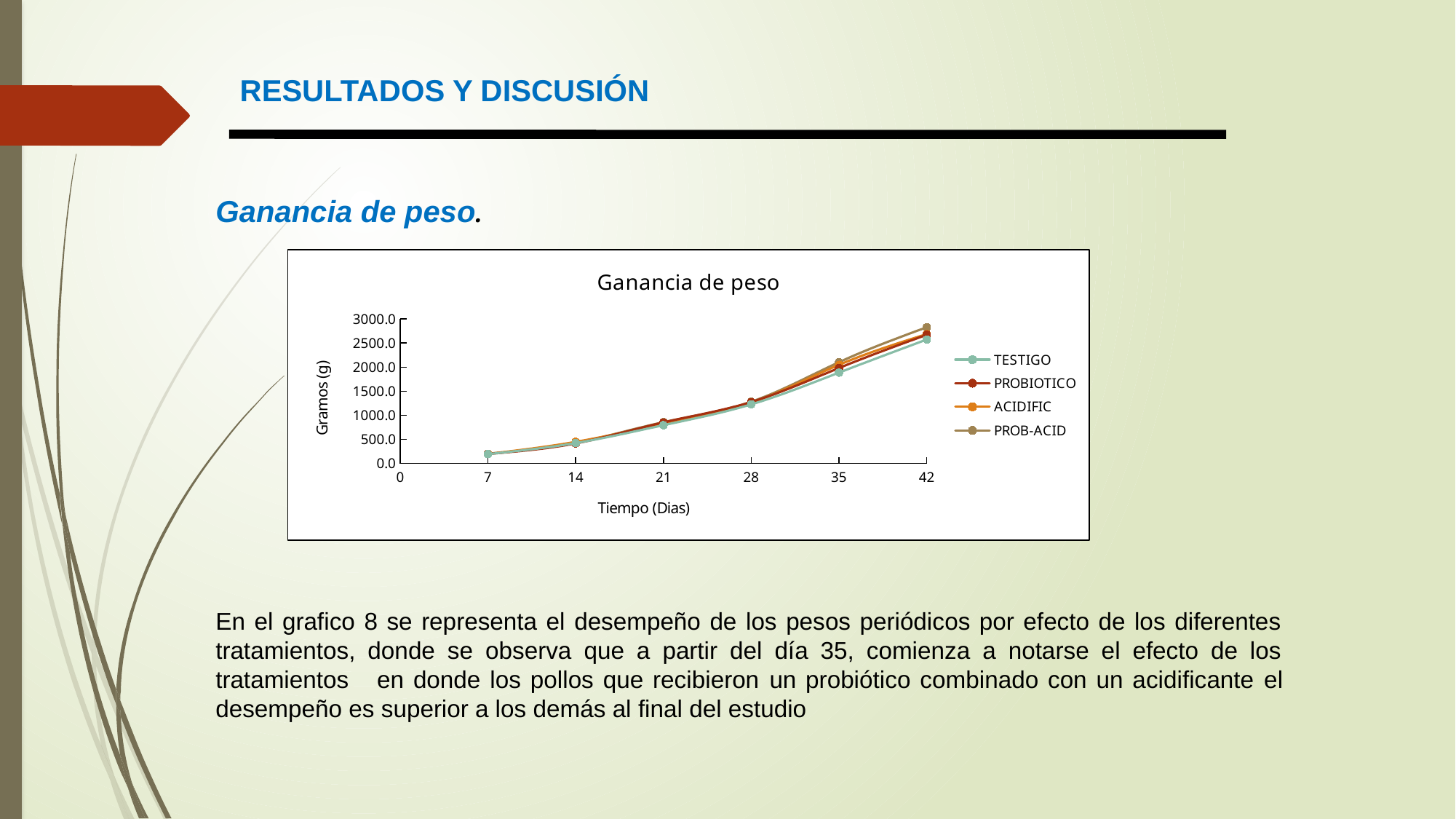
What is the title of the chart on the slide? Ganancia de peso At day 35, which is larger in the 'Ganancia de peso' chart: PROB-ACID or TESTIGO? PROB-ACID How many series does the legend of the 'Ganancia de peso' chart list? 4 What is the label of the x axis of the 'Ganancia de peso' chart? Tiempo (Dias) Do the values in the 'Ganancia de peso' chart rise or fall as the days increase? rise Is the value for TESTIGO at day 35 greater or less than 2000.0? less Which series has the highest value at day 42 in the 'Ganancia de peso' chart? PROB-ACID Is the value for TESTIGO at day 7 greater or less than 500.0? less Is the value for PROB-ACID at day 42 greater or less than 2500.0? greater How many time points are plotted for each series in the 'Ganancia de peso' chart? 6 What kind of chart is shown on the slide? line chart